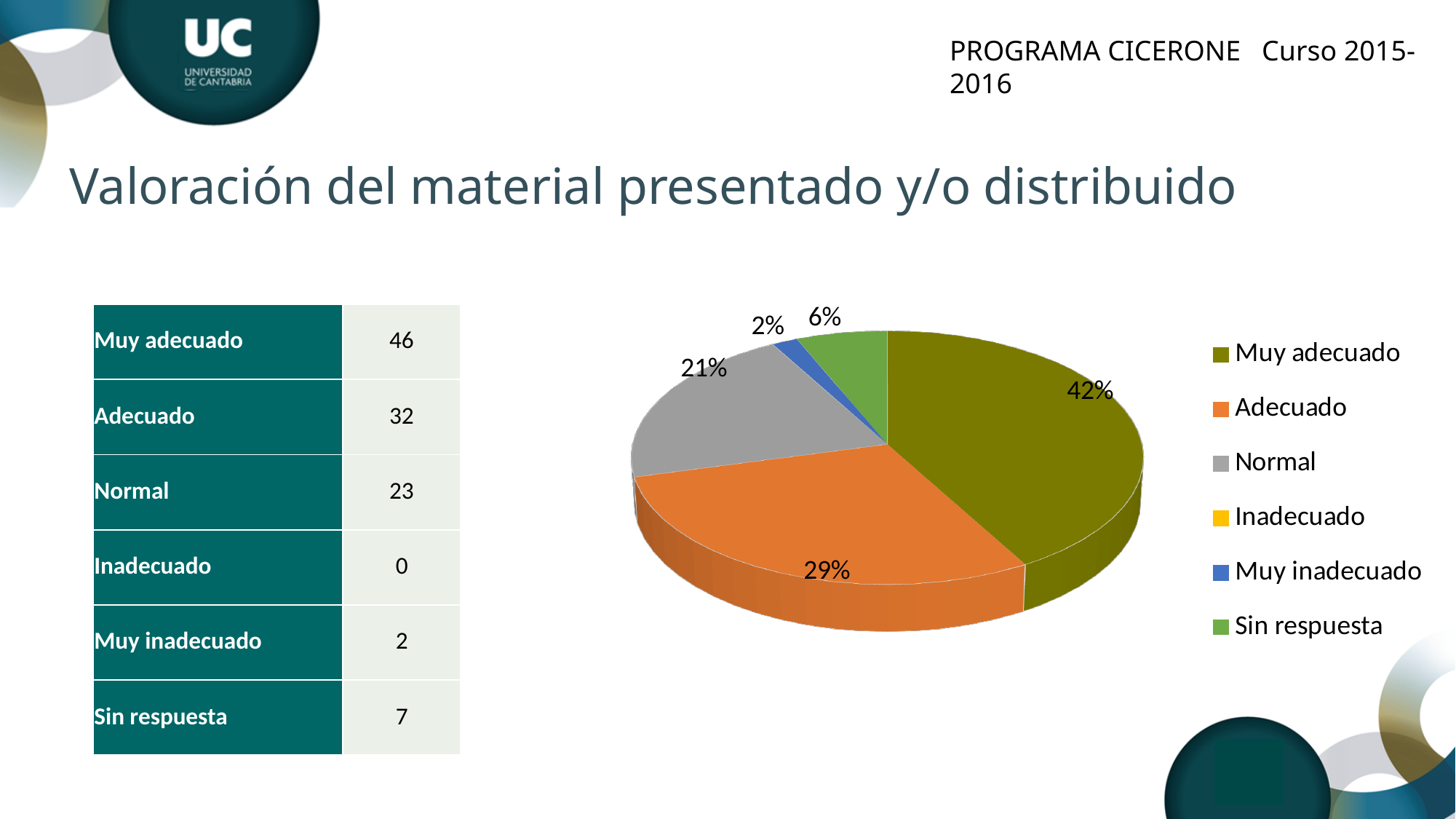
Which labelled slice of the pie is the smallest? Muy inadecuado How many entries does the legend of the pie chart list? 6 What share of the pie does the Sin respuesta slice represent? 6% What kind of chart is shown on the slide? pie chart Which slice is larger, Normal or Sin respuesta? Normal What colour is the Adecuado slice in the pie chart? orange What share of the pie does the Adecuado slice represent? 29% What share of the pie does the Muy adecuado slice represent? 42% What is the difference in percentage points between the Muy adecuado and Adecuado slices? 13 Which category has the largest slice of the pie? Muy adecuado